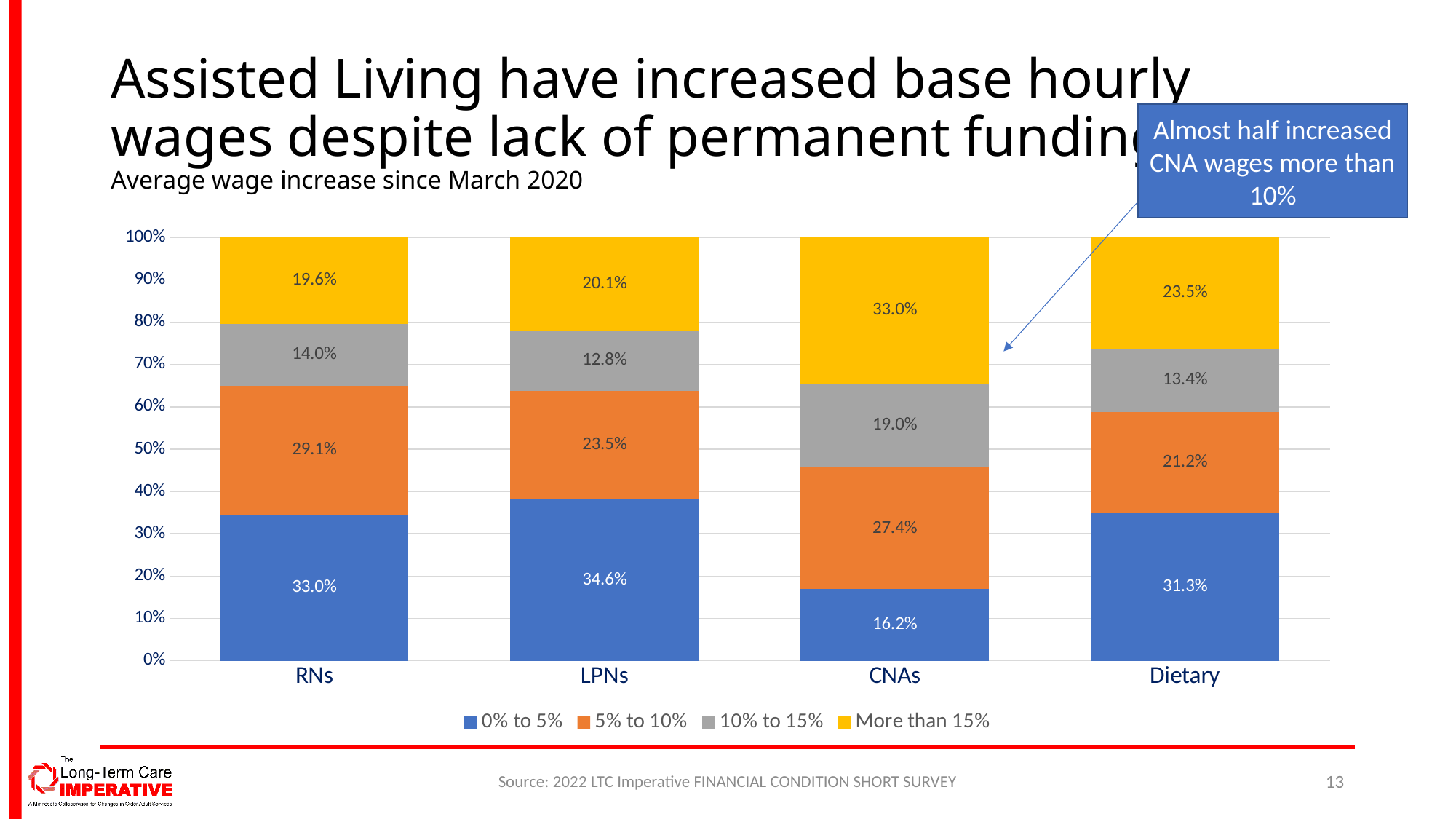
What is the difference between the '5% to 10%' values for RNs and Dietary? 7.9% What kind of chart is shown on the slide? Stacked bar chart Which category has the lowest value for the '0% to 5%' series? CNAs What is the subtitle shown above the chart? Average wage increase since March 2020 How many series does the chart legend list? 4 What is the value of the '10% to 15%' segment for Dietary? 13.4% Which category has the highest value for the 'More than 15%' series? CNAs Which is larger: the '10% to 15%' value for RNs or for LPNs? RNs How many categories are shown on the x axis of the chart? 4 Do the values of the '0% to 5%' series rise or fall from CNAs to Dietary? Rise What is the value of the '0% to 5%' segment for LPNs? 34.6% What is the value of the 'More than 15%' segment for CNAs? 33.0%